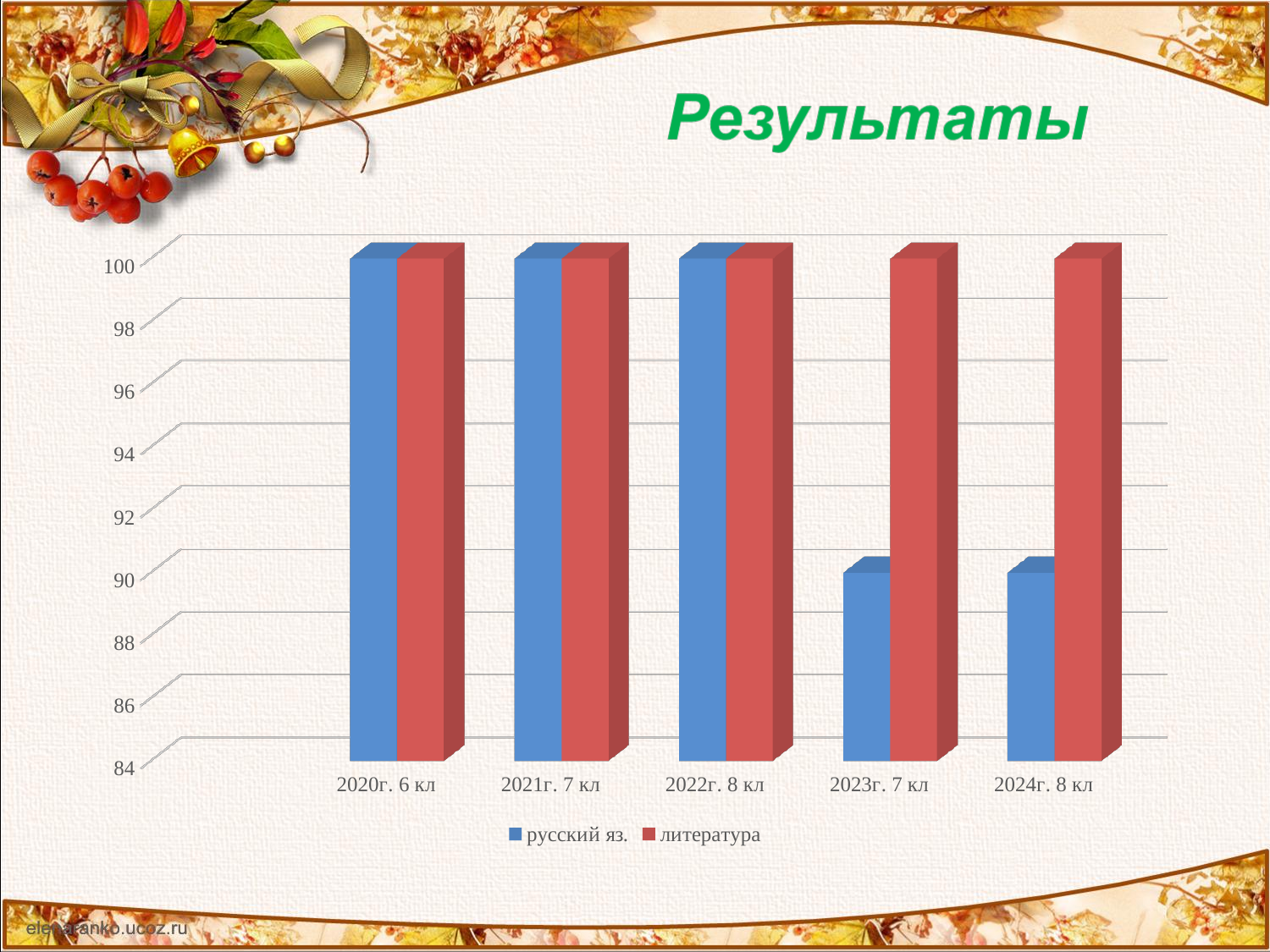
How many series does the legend list? 2 What is the value for русский яз. in 2020г. 6 кл? 100 What is the value for литература in 2024г. 8 кл? 100 Is the value for русский яз. in 2024г. 8 кл greater or less than 96? less What is the difference between литература and русский яз. in 2024г. 8 кл? 10 What kind of chart is shown on the slide? bar chart How many categories are shown on the x axis? 5 Which category has the lowest value for русский яз.? 2023г. 7 кл and 2024г. 8 кл In 2023г. 7 кл, which is larger: русский яз. or литература? литература What is the value for русский яз. in 2023г. 7 кл? 90 Which series is shown in blue? русский яз. What is the title of the slide above the chart? Результаты